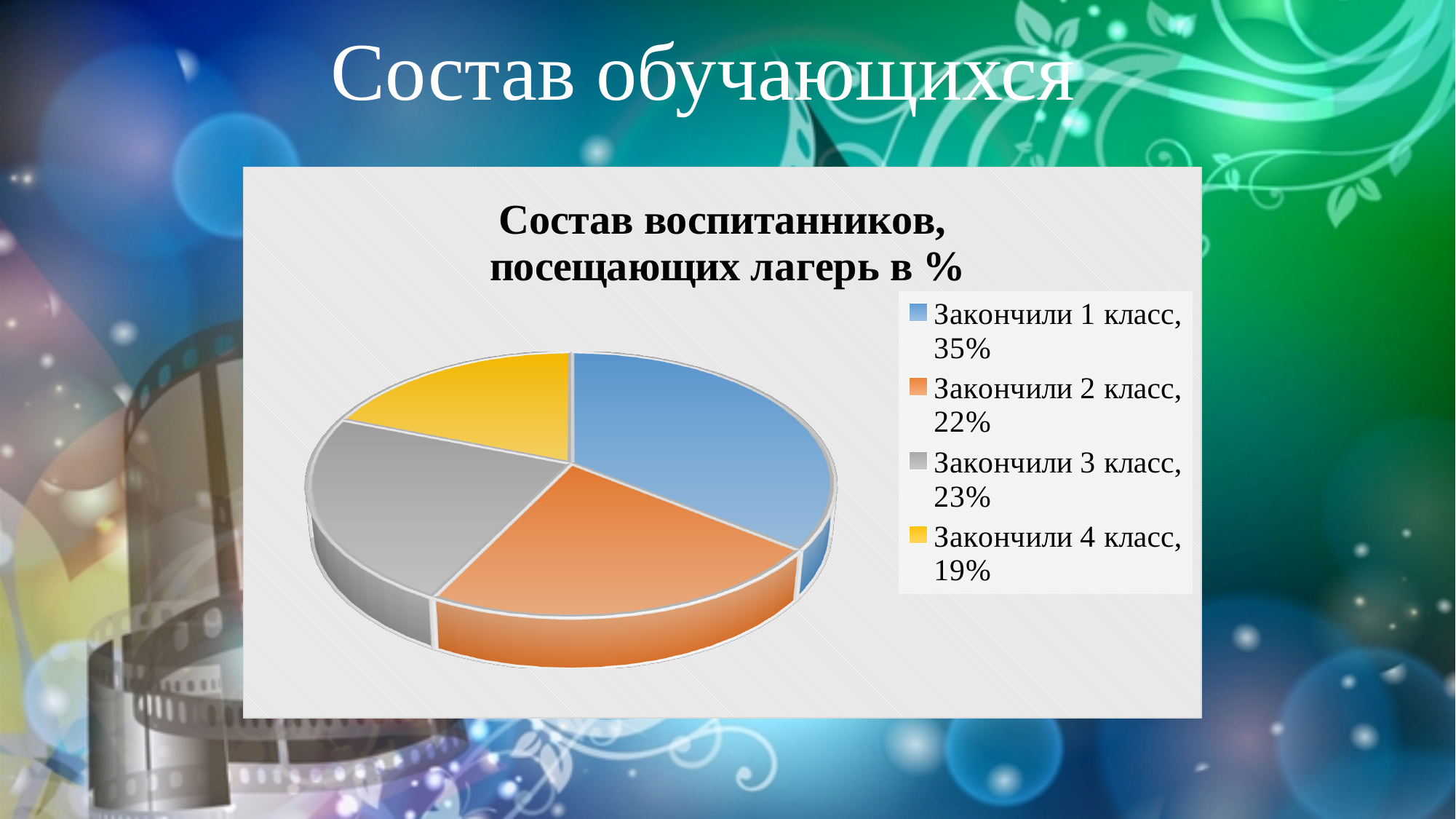
Which category has the smallest share of the pie? Закончили 4 класс What share of the pie corresponds to "Закончили 1 класс"? 35% What colour is the slice for "Закончили 4 класс"? yellow How many categories does the pie chart have? 4 What share of the pie corresponds to "Закончили 4 класс"? 19% What type of chart is shown on the slide? pie chart What share of the pie corresponds to "Закончили 2 класс"? 22% What is the difference in percentage points between "Закончили 1 класс" and "Закончили 4 класс"? 16 What is the title of the chart? Состав воспитанников, посещающих лагерь в % What share of the pie corresponds to "Закончили 3 класс"? 23% Which category has the largest share of the pie? Закончили 1 класс Which is larger: the share for "Закончили 1 класс" or for "Закончили 3 класс"? Закончили 1 класс